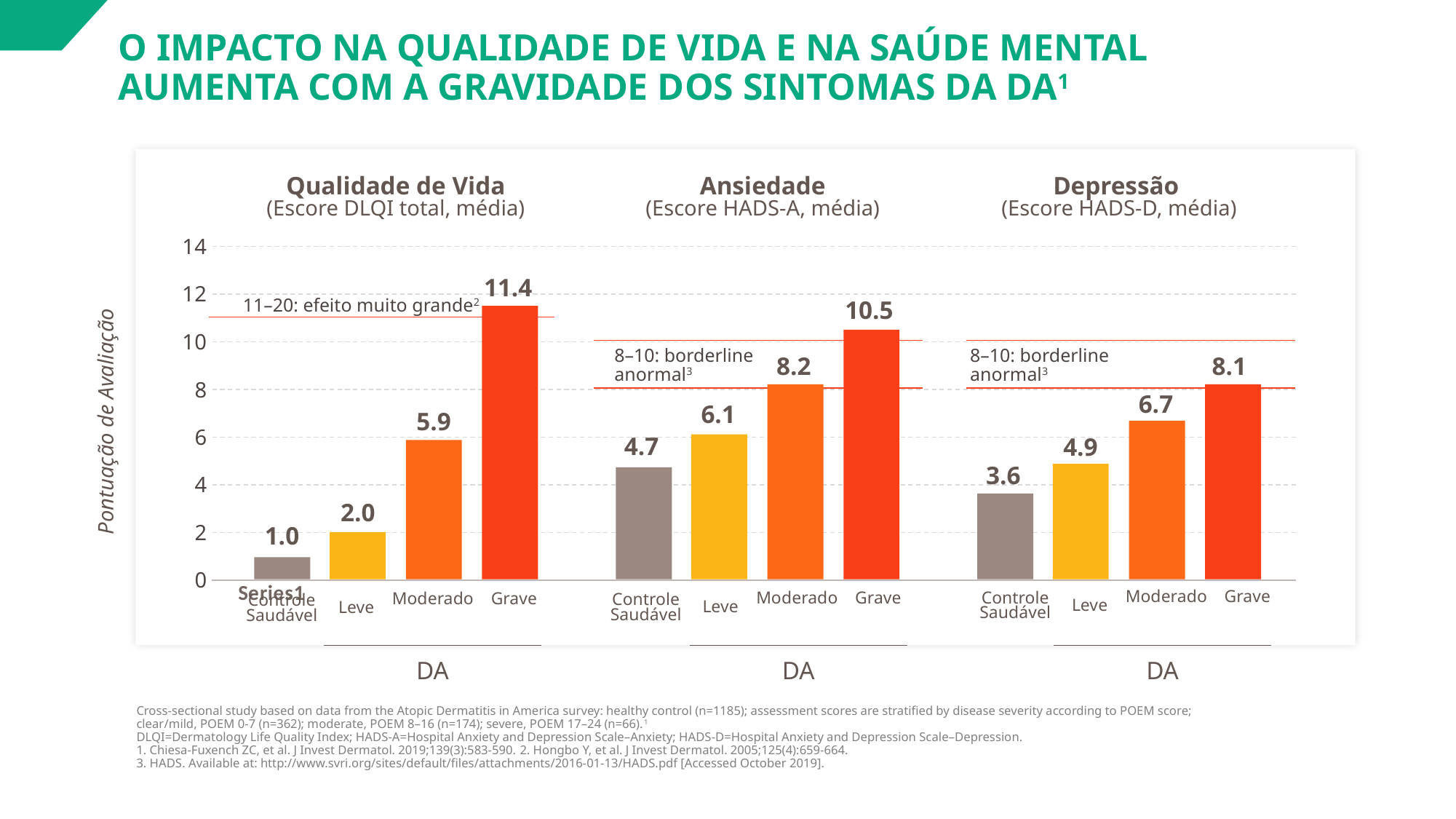
In the Depressão chart, which category has the lowest value? Controle Saudável In the Qualidade de Vida chart, is the value for Moderado greater or less than 4? greater In the Qualidade de Vida chart, what is the value for Grave? 11.4 In the Ansiedade chart, what is the difference between the values for Leve and Controle Saudável? 1.4 In the Depressão chart, what is the value for Moderado? 6.7 What kind of chart is used on this slide? Bar chart In the Ansiedade chart, which category has the highest value? Grave Which is larger: the value for Grave in the Depressão chart or the value for Moderado in the Ansiedade chart? Moderado in the Ansiedade chart In the Ansiedade chart, what is the value for Controle Saudável? 4.7 In the Ansiedade chart, do the values rise or fall from Controle Saudável to Grave? Rise In the Qualidade de Vida chart, what is the difference between the values for Grave and Moderado? 5.5 How many categories are shown in the Depressão chart? 4